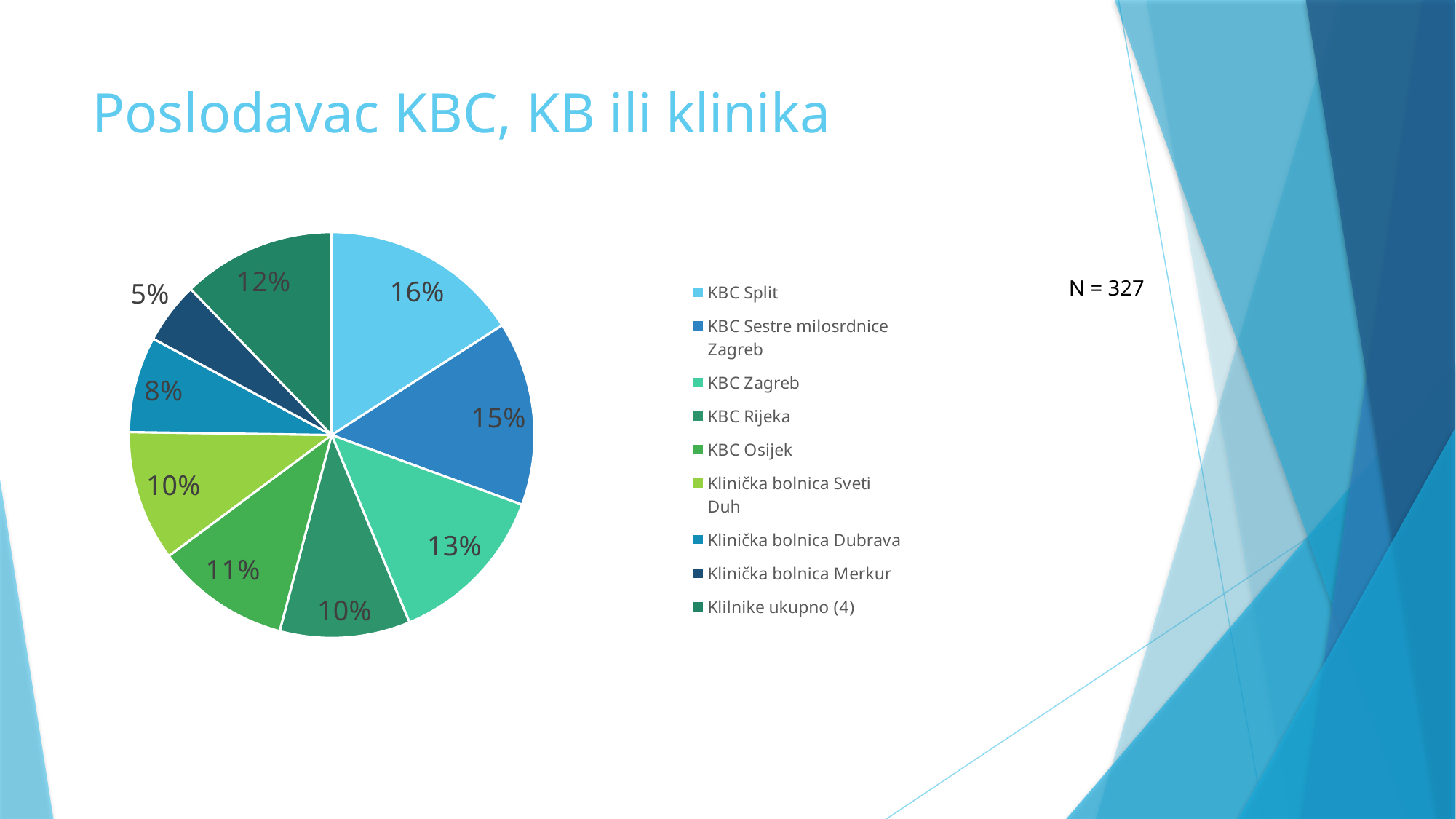
What share of the pie does Klinička bolnica Merkur have? 5% What share of the pie does Klilnike ukupno (4) have? 12% How many categories does the legend list? 9 What is the difference in percentage points between KBC Split and Klinička bolnica Merkur? 11 What share of the pie does KBC Sestre milosrdnice Zagreb have? 15% Which category has the largest slice of the pie? KBC Split Which is larger, the slice for KBC Osijek or the slice for Klinička bolnica Dubrava? KBC Osijek Which category has the smallest slice of the pie? Klinička bolnica Merkur What kind of chart is shown on the slide? pie chart